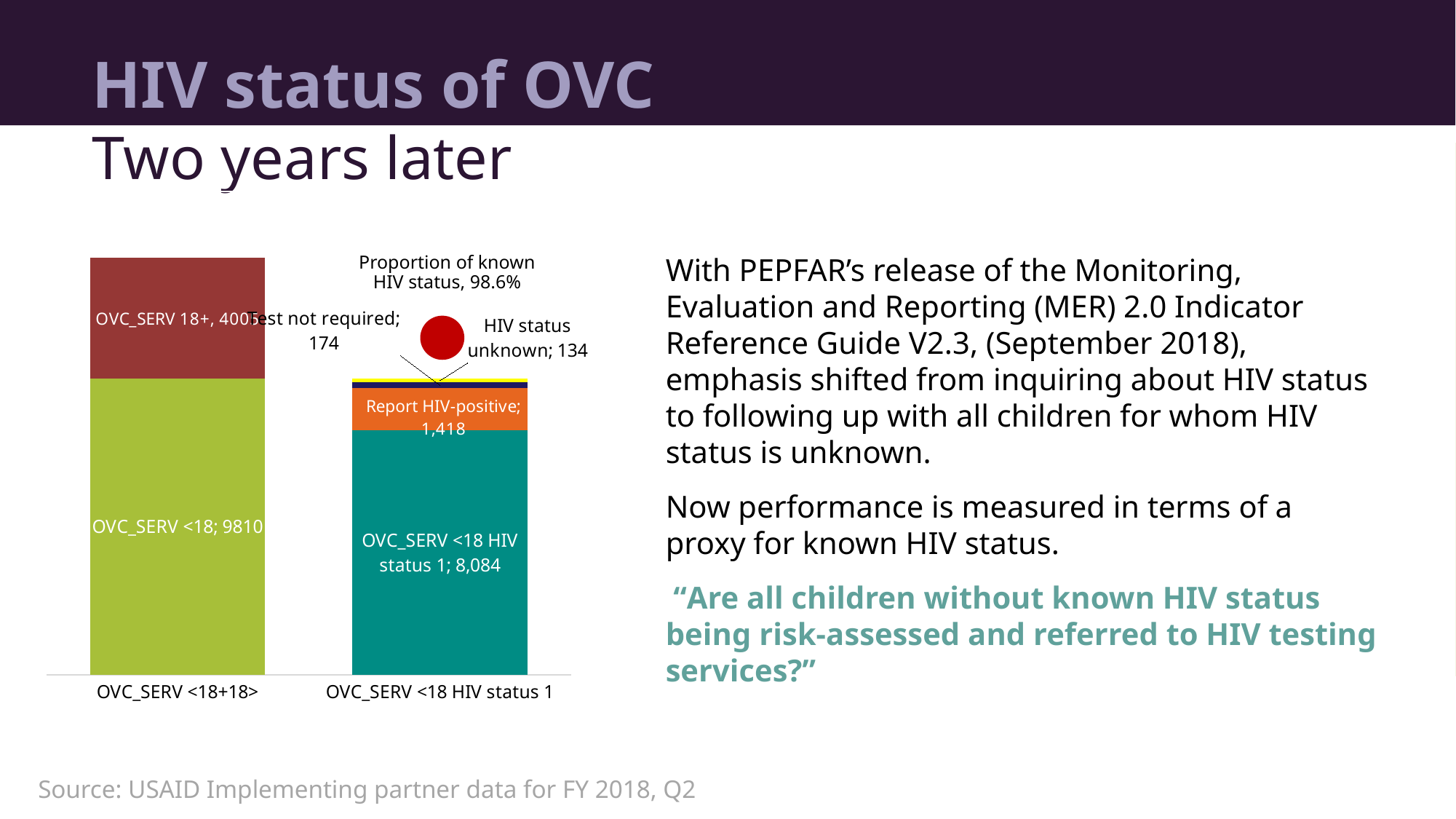
What is the value of the Report HIV-positive segment? 1,418 What proportion of known HIV status is shown on the chart? 98.6% What is the total of the OVC_SERV <18 HIV status 1 stacked bar (8,084 + 1,418 + 174 + 134)? 9,810 Which segment of the OVC_SERV <18 HIV status 1 bar has the smallest value? HIV status unknown What is the value of the HIV status unknown segment? 134 How many bars are plotted on the chart? 2 Which is larger, the Report HIV-positive segment or the HIV status unknown segment? Report HIV-positive What kind of chart is shown on the slide? Stacked bar chart What is the difference between the Report HIV-positive value and the HIV status unknown value? 1,284 What is the value of the OVC_SERV <18 HIV status 1 segment in the second bar? 8,084 What is the value of the OVC_SERV <18 segment in the OVC_SERV <18+18> bar? 9810 What is the value of the Test not required segment? 174